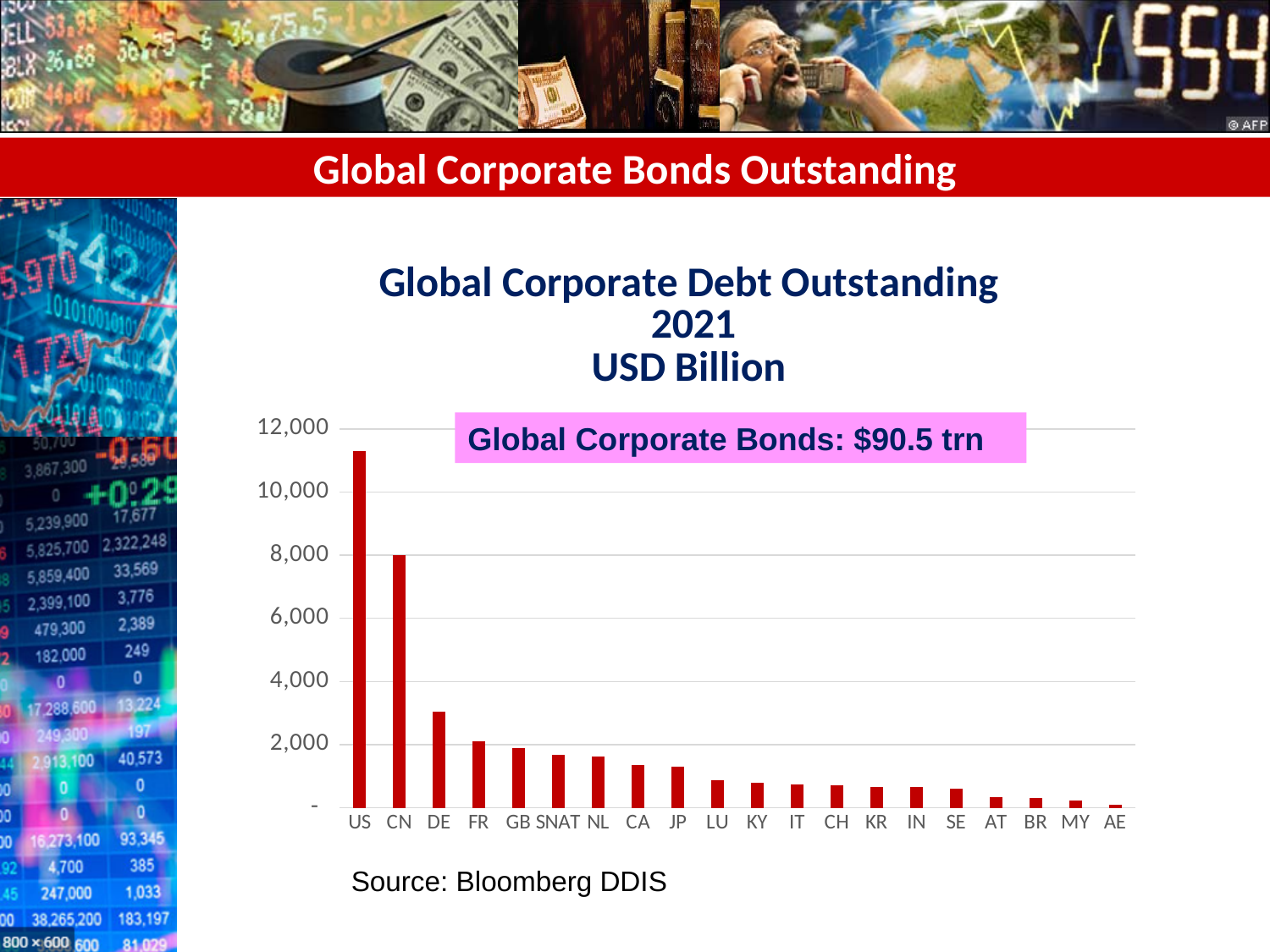
What total for global corporate bonds is stated in the text box on the chart? $90.5 trn Which category has the lowest corporate debt outstanding in the chart? AE How many categories are shown on the x axis of the chart? 20 Do the values rise or fall moving from left to right along the x axis? fall Is the value for US greater or less than 10,000? greater Is the value for DE greater or less than 2,000? greater Which is larger, the value for US or the value for CN? US Which country has the highest corporate debt outstanding in the chart? US What kind of chart is shown on the slide? bar chart Is the value for CA greater or less than 2,000? less Which is larger, the value for DE or the value for FR? DE